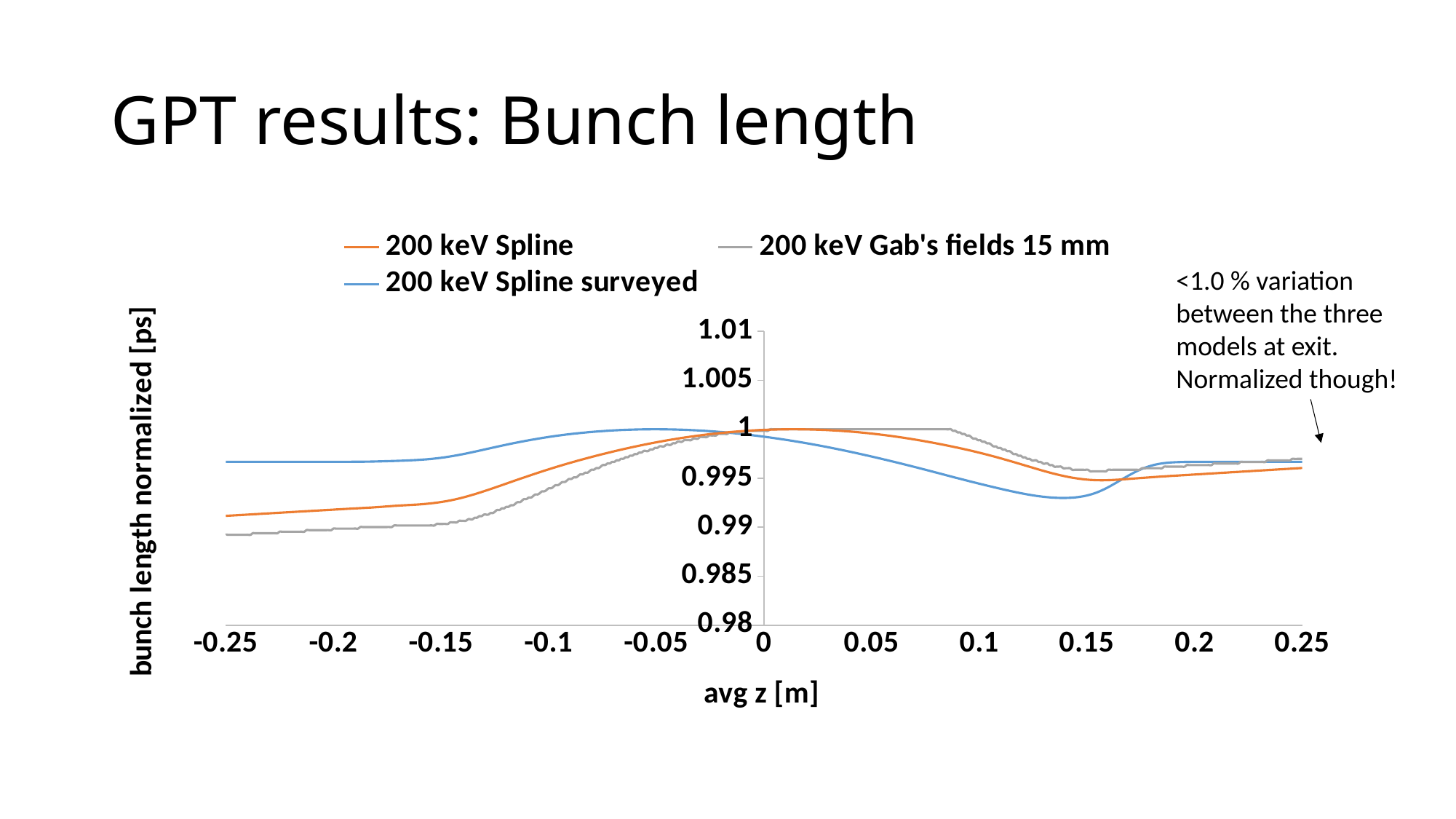
Does the 200 keV Spline surveyed series rise or fall between avg z = -0.25 and avg z = -0.05? rise What kind of chart is shown on the slide? line chart Which series has the lowest value at avg z = -0.25? 200 keV Gab's fields 15 mm Is the value of the 200 keV Spline series at avg z = -0.25 greater or less than 0.995? less How many series does the legend list? 3 Does the 200 keV Spline series rise or fall between avg z = 0 and avg z = 0.15? fall Which series has the highest value at avg z = -0.25? 200 keV Spline surveyed What is the title of the x axis? avg z [m] What is the title of the y axis? bunch length normalized [ps] Is the value of the 200 keV Spline surveyed series at avg z = 0.15 greater or less than 0.995? less Is the value of the 200 keV Spline surveyed series at avg z = -0.25 greater or less than 0.995? greater Which series has the lowest value at avg z = 0.15? 200 keV Spline surveyed